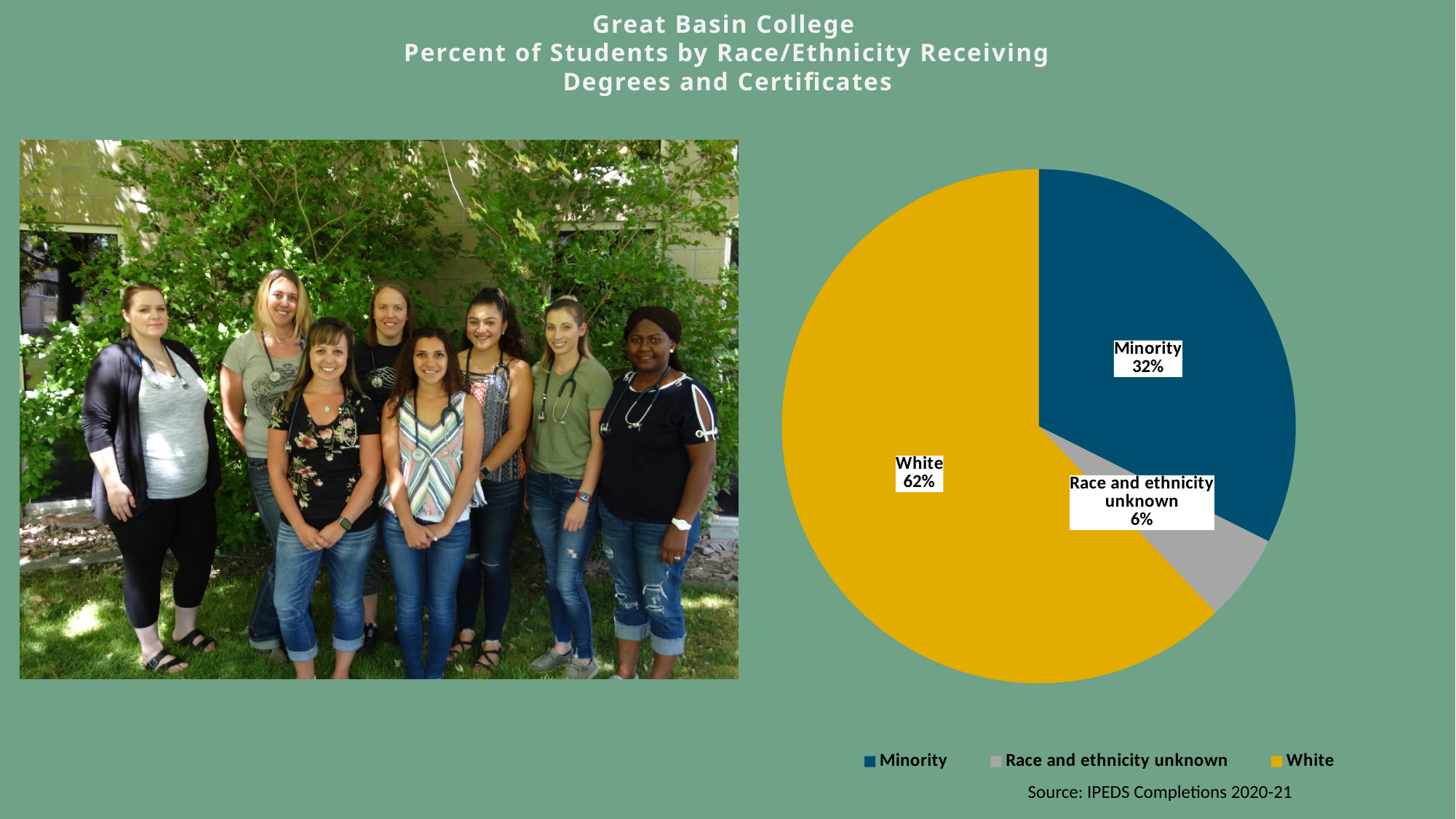
What colour is the White slice in the pie chart? Yellow What is the source cited for the chart data? IPEDS Completions 2020-21 What percentage of students receiving degrees and certificates have race and ethnicity unknown? 6% Which is larger, the Minority share or the Race and ethnicity unknown share? Minority What percentage of students receiving degrees and certificates are White? 62% How many categories are shown in the pie chart? 3 Which category has the largest share of the pie? White Which category has the smallest share of the pie? Race and ethnicity unknown What kind of chart is shown on the slide? Pie chart What percentage of students receiving degrees and certificates are Minority? 32% What is the combined share of the Minority and Race and ethnicity unknown slices? 38% What is the difference in percentage points between the White and Minority shares? 30